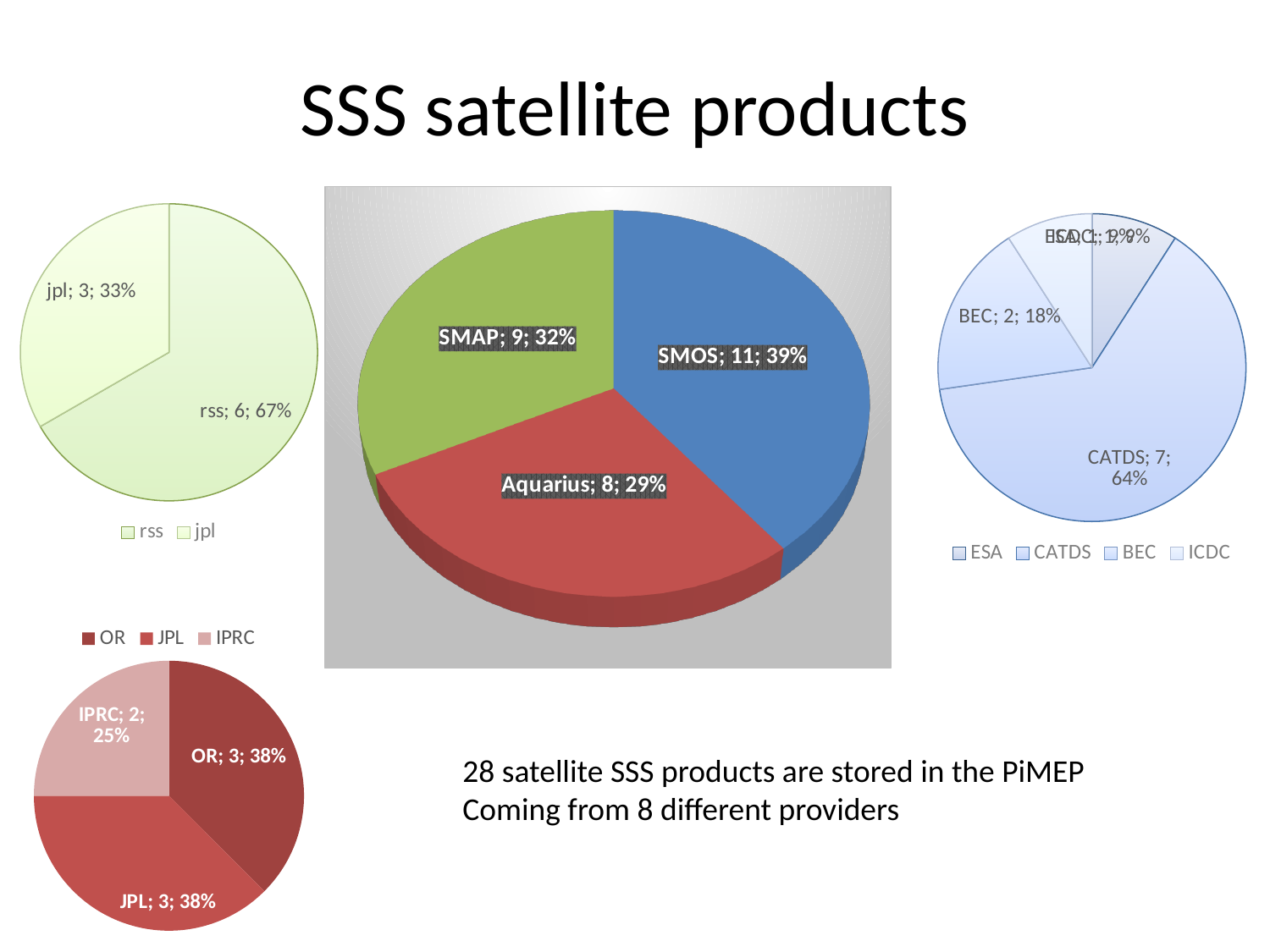
What kind of chart is the large chart in the centre of the slide? Pie chart In the large centre pie chart, which slice is the largest? SMOS In the top-left green pie chart, which is larger, rss or jpl? rss In the top-right blue pie chart, what share of the pie does CATDS take? 64% In the large centre pie chart, what is the difference between the SMOS count and the Aquarius count? 3 In the bottom-left red pie chart, what is the value shown for IPRC? 2; 25% In the top-right blue pie chart, what is the value shown for BEC? 2; 18% In the top-left green pie chart, what is the value shown for rss? 6; 67% How many entries does the legend of the top-right blue pie chart list? 4 In the large centre pie chart, what share of the pie does SMAP take? 32% In the large centre pie chart, what is the value shown for SMOS? 11; 39% In the large centre pie chart, which slice is the smallest? Aquarius